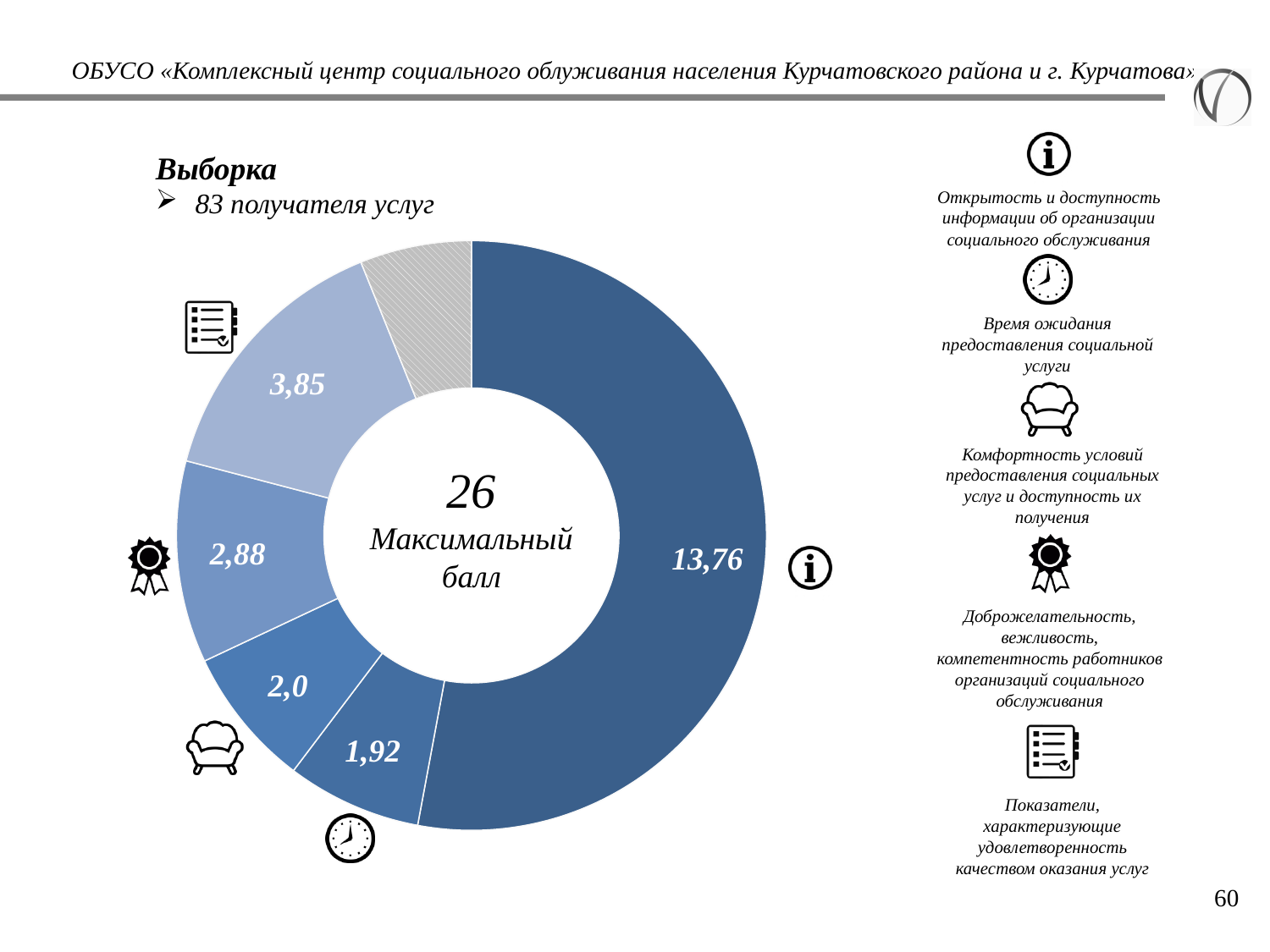
What value is shown for the slice marked with the checklist icon (Показатели, характеризующие удовлетворенность качеством оказания услуг)? 3,85 Which is larger: the slice for Доброжелательность (medal icon) or the slice for Комфортность условий (armchair icon)? Доброжелательность (2,88) Which labelled slice of the donut chart has the highest value? 13,76 (Открытость и доступность информации) What value is shown for the slice marked with the armchair icon (Комфортность условий предоставления социальных услуг)? 2,0 What value is shown for the slice marked with the clock icon (Время ожидания предоставления социальной услуги)? 1,92 What value is shown for the slice marked with the information icon (Открытость и доступность информации об организации социального обслуживания)? 13,76 What number and text are printed in the centre of the donut chart? 26 Максимальный балл What value is shown for the slice marked with the medal icon (Доброжелательность, вежливость, компетентность работников)? 2,88 What is the difference between the largest labelled slice (13,76) and the slice labelled 3,85? 9,91 How many slices of the donut chart have a printed value label? 5 Which labelled slice of the donut chart has the lowest value? 1,92 (Время ожидания предоставления социальной услуги) What kind of chart is shown on the slide? Pie (donut) chart